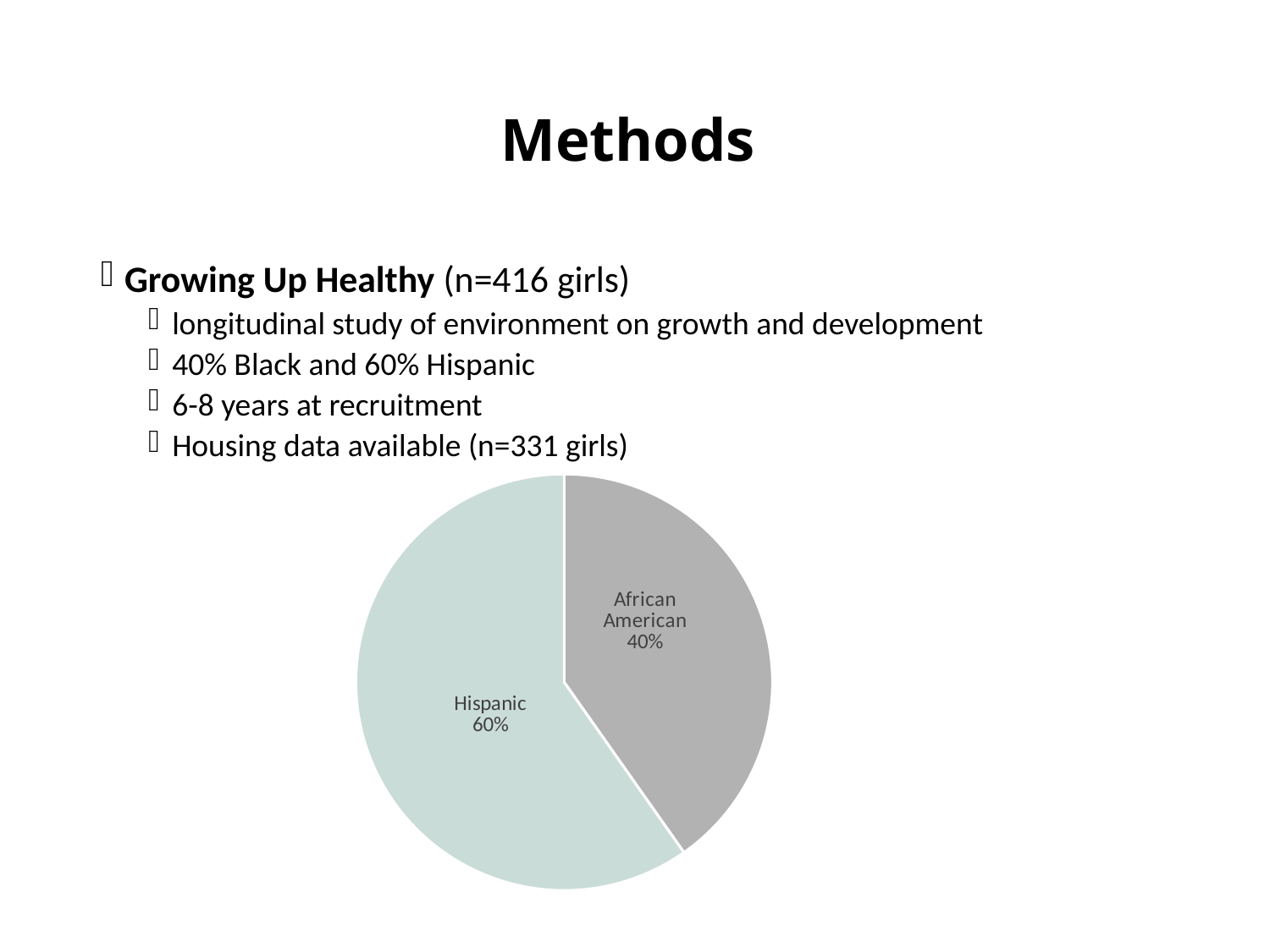
Which slice of the pie is shaded light green? Hispanic What is the difference in percentage points between the Hispanic and African American slices? 20% What kind of chart is shown on the slide? pie chart Which slice of the pie is the largest? Hispanic What is the combined share of the Hispanic and African American slices? 100% What share of the pie does the Hispanic slice represent? 60% What share of the pie does the African American slice represent? 40% How many slices does the pie chart have? 2 Which slice of the pie is shaded grey? African American Which is larger, the Hispanic slice or the African American slice? Hispanic Which slice of the pie is the smallest? African American